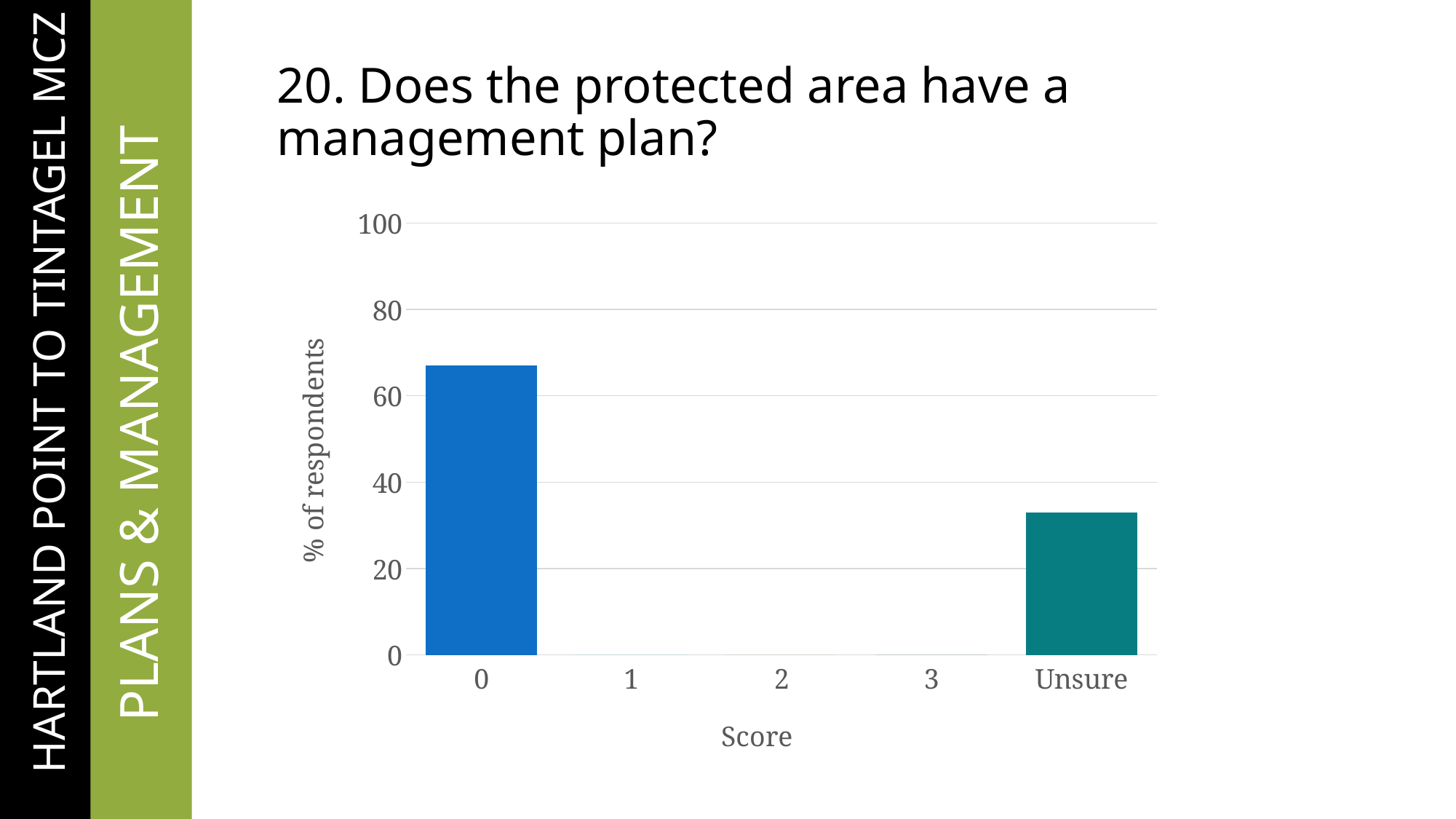
Is the value for score 0 greater or less than 80? less What kind of chart is shown on the slide? bar chart What is the percentage of respondents for score 2? 0 Which score category has the highest percentage of respondents? 0 How many categories are shown on the x axis of the chart? 5 Is the value for Unsure greater or less than 20? greater What is the label of the y axis? % of respondents Which has a higher percentage of respondents, score 0 or Unsure? 0 Is the value for score 0 greater or less than 60? greater What is the label of the x axis? Score